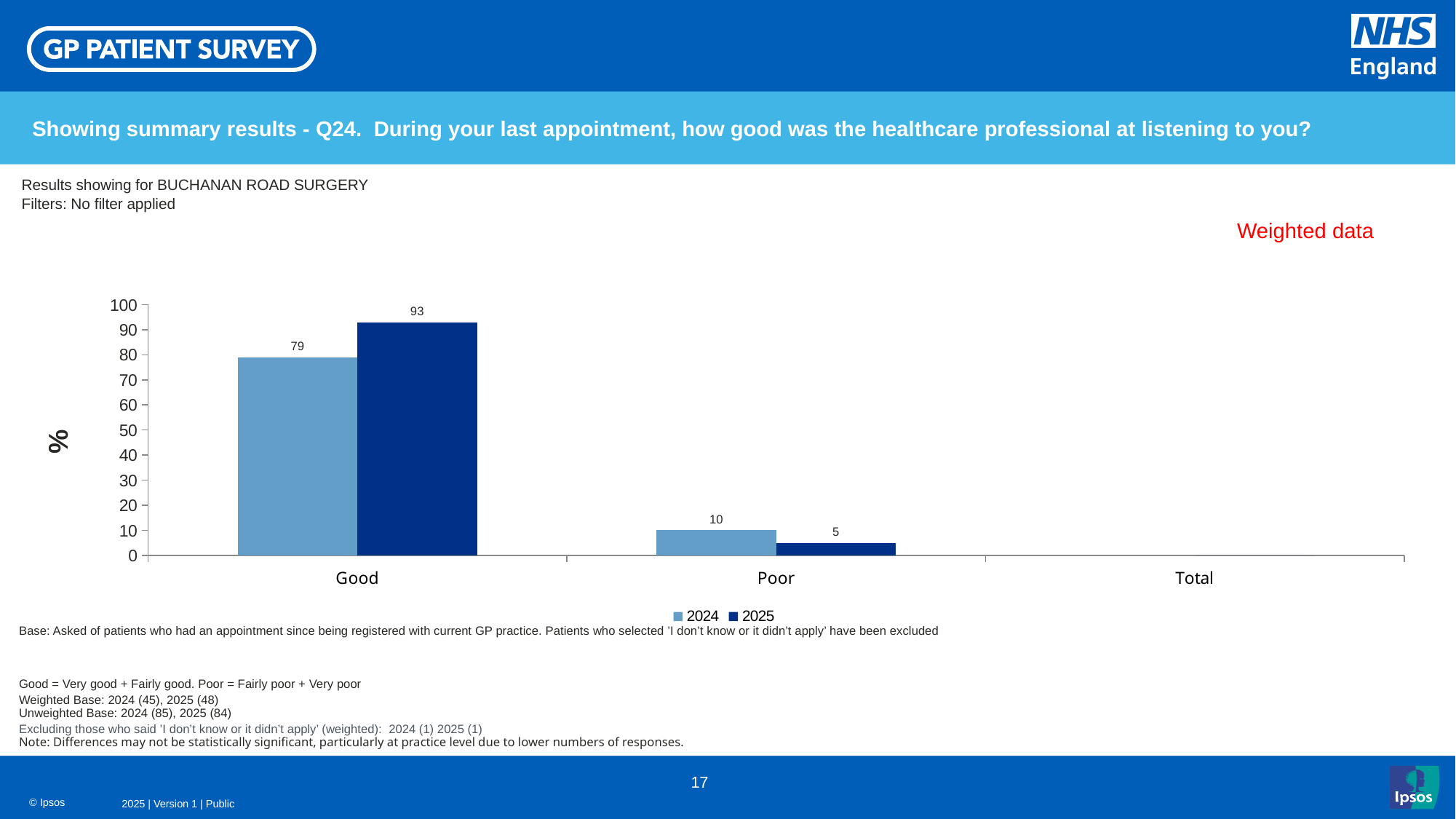
What is the value for Good in 2025? 93 What is the value for Good in 2024? 79 Which category has the highest value for 2025? Good How many series does the legend list? 2 Which is larger, the 2024 value for Good or the 2025 value for Good? 2025 What is the label on the vertical axis? % What is the difference between the 2024 and 2025 values for Poor? 5 What kind of chart is shown on the slide? Bar chart What is the difference between the 2025 and 2024 values for Good? 14 What is the value for Poor in 2025? 5 Which category has the lowest value for 2024? Poor What is the value for Poor in 2024? 10